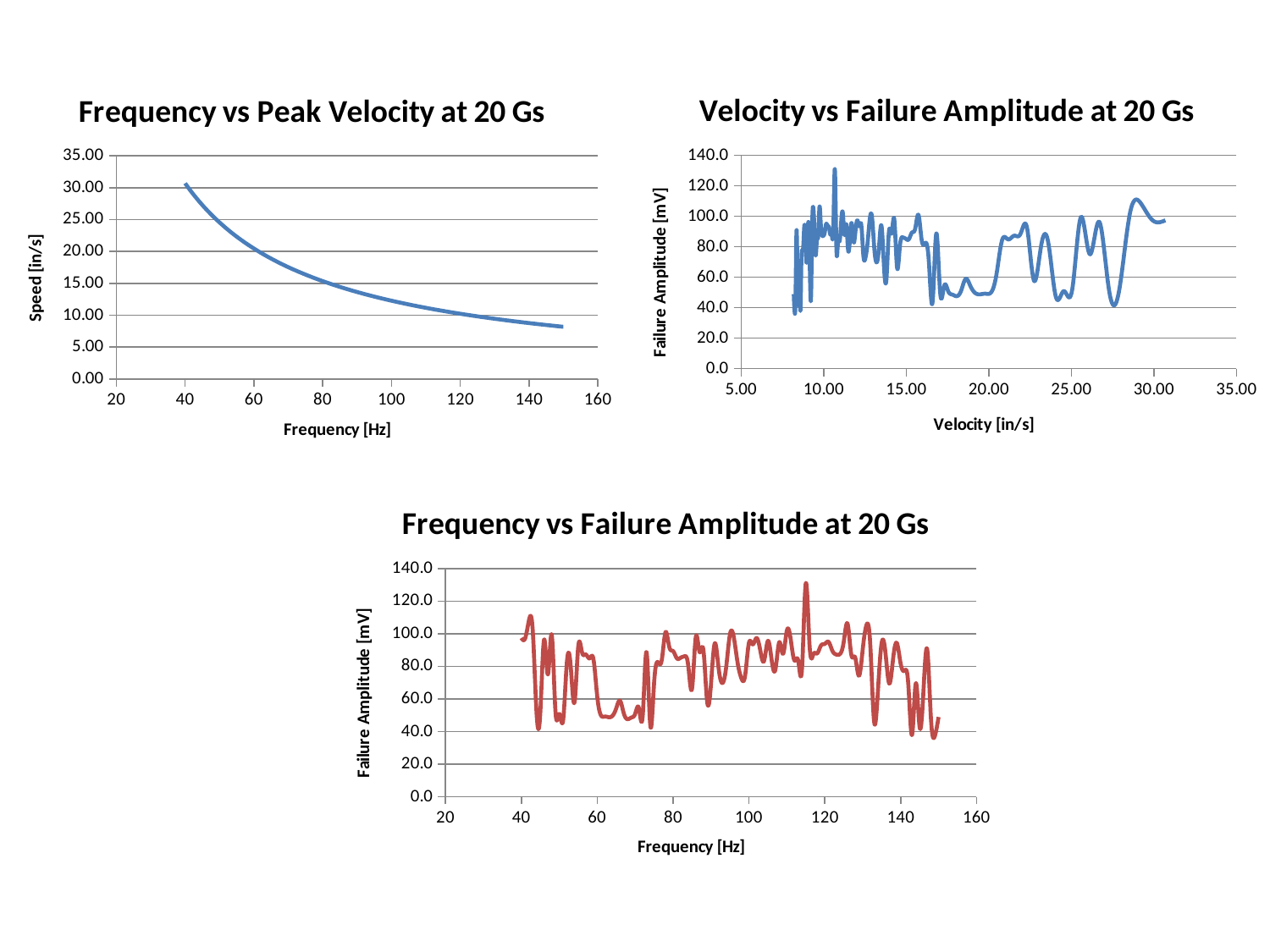
In "Frequency vs Peak Velocity at 20 Gs", is the speed at 150 Hz greater or less than 10.00 in/s? less How many charts are shown on the slide? 3 What type of chart is "Frequency vs Failure Amplitude at 20 Gs"? line chart In "Frequency vs Peak Velocity at 20 Gs", does the speed rise or fall as frequency increases? fall What is the y-axis title of "Frequency vs Peak Velocity at 20 Gs"? Speed [in/s] What type of chart is "Frequency vs Peak Velocity at 20 Gs"? line chart In "Frequency vs Failure Amplitude at 20 Gs", is the peak failure amplitude greater or less than 120.0 mV? greater In "Velocity vs Failure Amplitude at 20 Gs", is the highest failure amplitude greater or less than 120.0 mV? greater What is the x-axis title of "Velocity vs Failure Amplitude at 20 Gs"? Velocity [in/s]